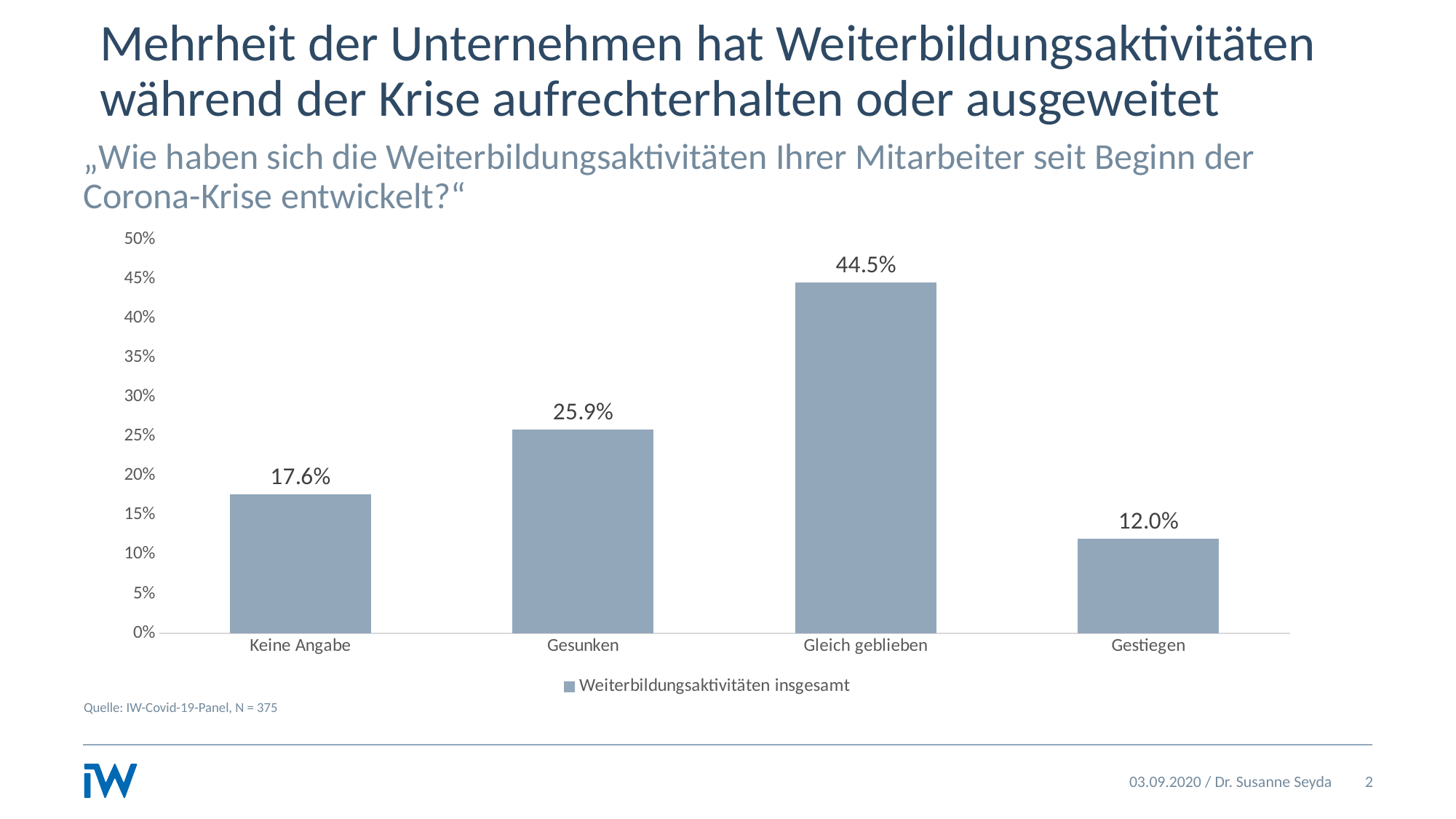
How many categories are shown on the x axis? 4 What series name does the legend show? Weiterbildungsaktivitäten insgesamt What is the value for Gesunken? 25.9% Is the value for Gesunken greater or less than 30%? less Which is larger, the value for Keine Angabe or the value for Gestiegen? Keine Angabe Which category has the lowest value? Gestiegen What is the value for Keine Angabe? 17.6% What is the difference between the values for Gleich geblieben and Gesunken? 18.6% What kind of chart is shown on the slide? bar chart Which category has the highest value? Gleich geblieben What is the value for Gestiegen? 12.0% What is the value for Gleich geblieben? 44.5%